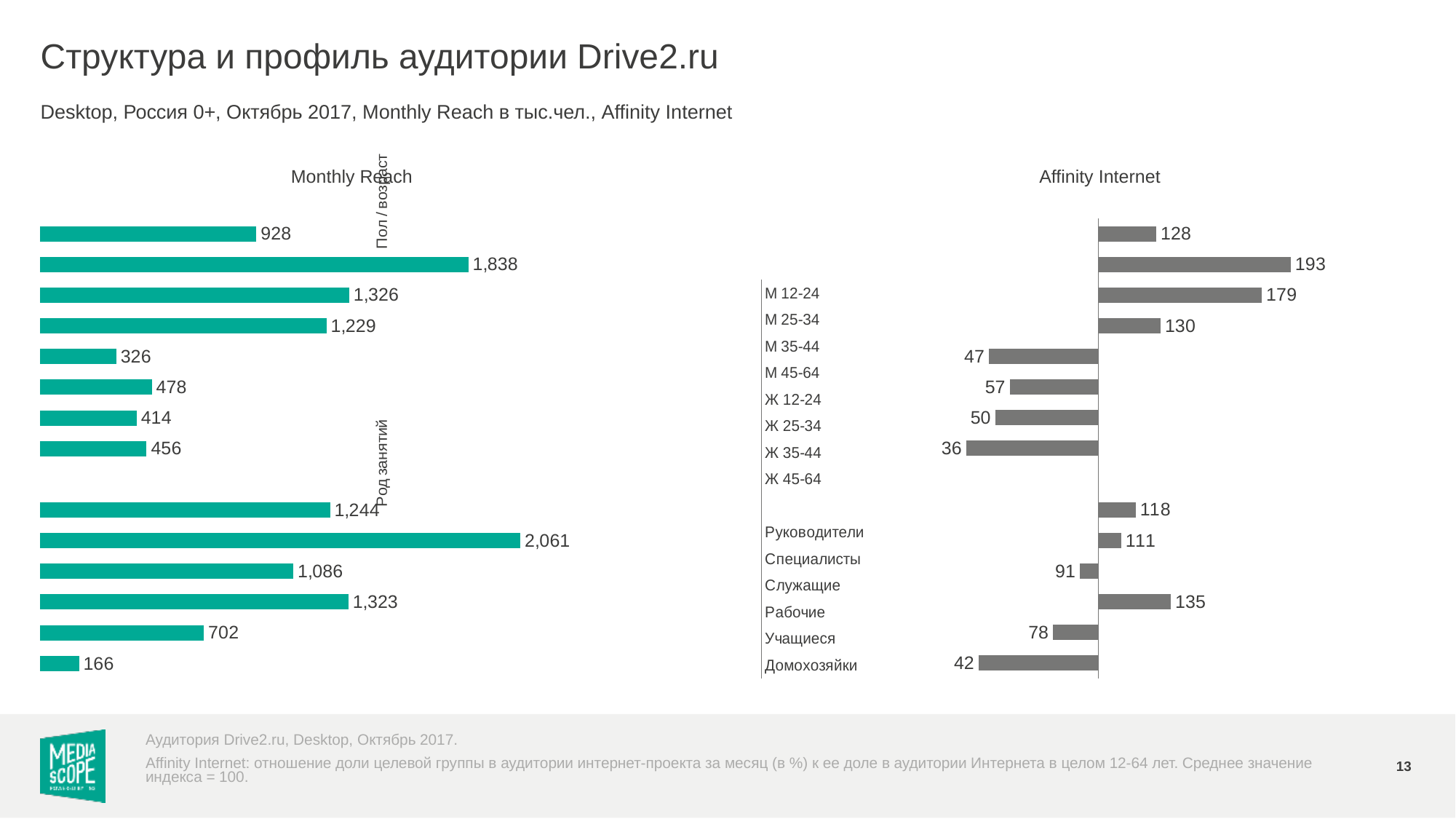
In the Affinity Internet chart, how many bars have values below 100? 7 What is the lowest value shown in the Monthly Reach chart? 166 In the Monthly Reach chart, what is the value of the topmost bar? 928 What is the lowest value shown in the Affinity Internet chart? 36 How many bars are plotted in the Monthly Reach chart? 14 What kind of chart is the Monthly Reach chart on the left? bar chart What is the difference between the highest and lowest values in the Affinity Internet chart? 157 What is the highest value shown in the Affinity Internet chart? 193 What colour are the bars in the Monthly Reach chart? teal What is the highest value shown in the Monthly Reach chart? 2,061 What is the difference between the highest and lowest values in the Monthly Reach chart? 1,895 How many bars are plotted in the Affinity Internet chart? 14